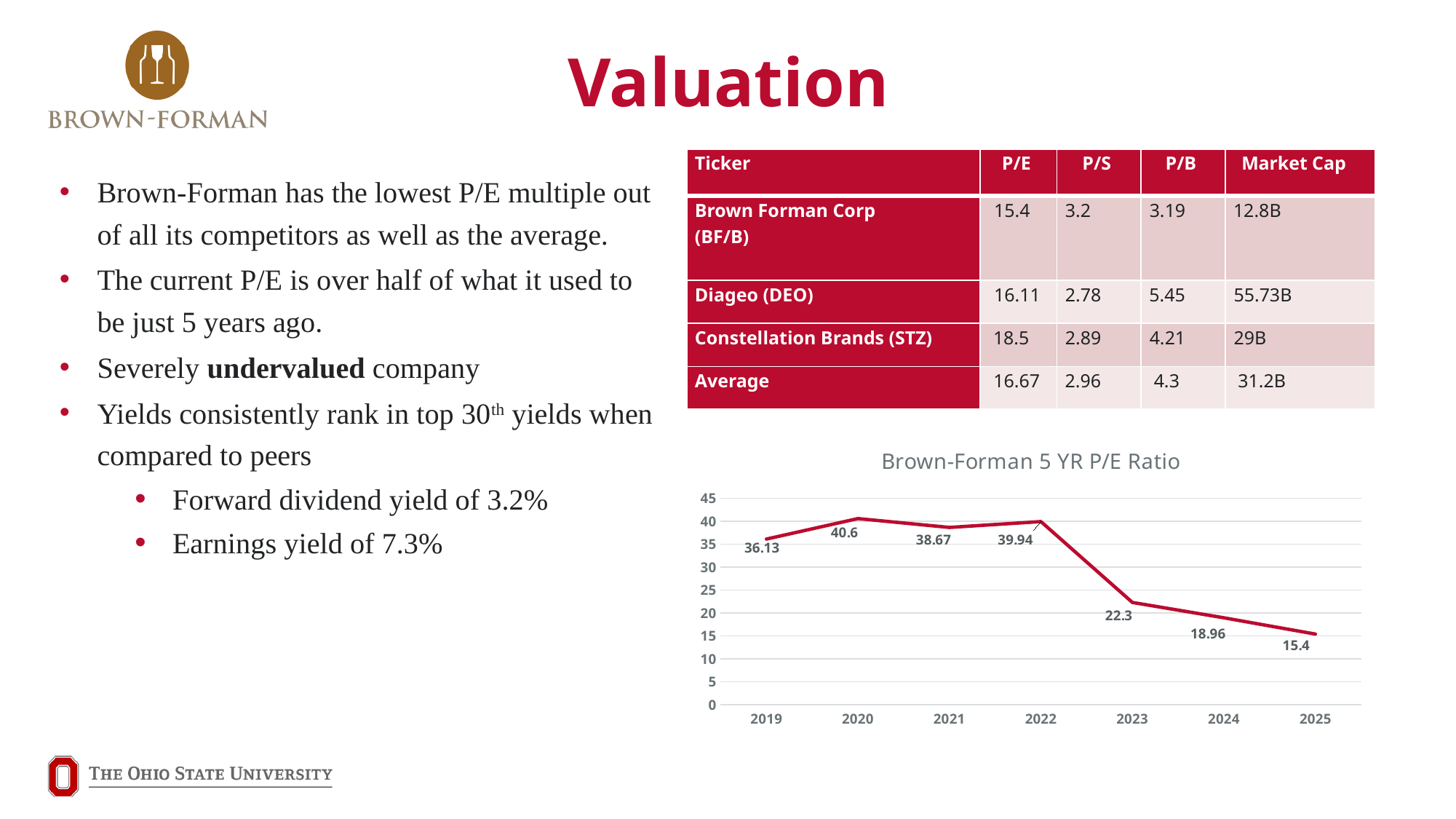
What is the P/E ratio for 2023 in the Brown-Forman 5 YR P/E Ratio chart? 22.3 What kind of chart is the Brown-Forman 5 YR P/E Ratio chart? line chart Does the P/E ratio rise or fall from 2022 to 2025 in the Brown-Forman 5 YR P/E Ratio chart? fall In the Brown-Forman 5 YR P/E Ratio chart, is the P/E ratio higher in 2021 or 2024? 2021 What is the P/E ratio for 2020 in the Brown-Forman 5 YR P/E Ratio chart? 40.6 What is the P/E ratio for 2025 in the Brown-Forman 5 YR P/E Ratio chart? 15.4 What is the difference between the 2022 and 2023 P/E ratios in the Brown-Forman 5 YR P/E Ratio chart? 17.64 What is the title of the line chart on the slide? Brown-Forman 5 YR P/E Ratio Which year has the highest P/E ratio in the Brown-Forman 5 YR P/E Ratio chart? 2020 In the Brown-Forman 5 YR P/E Ratio chart, is the value for 2019 greater or less than 30? greater Which year has the lowest P/E ratio in the Brown-Forman 5 YR P/E Ratio chart? 2025 How many years are plotted in the Brown-Forman 5 YR P/E Ratio chart? 7